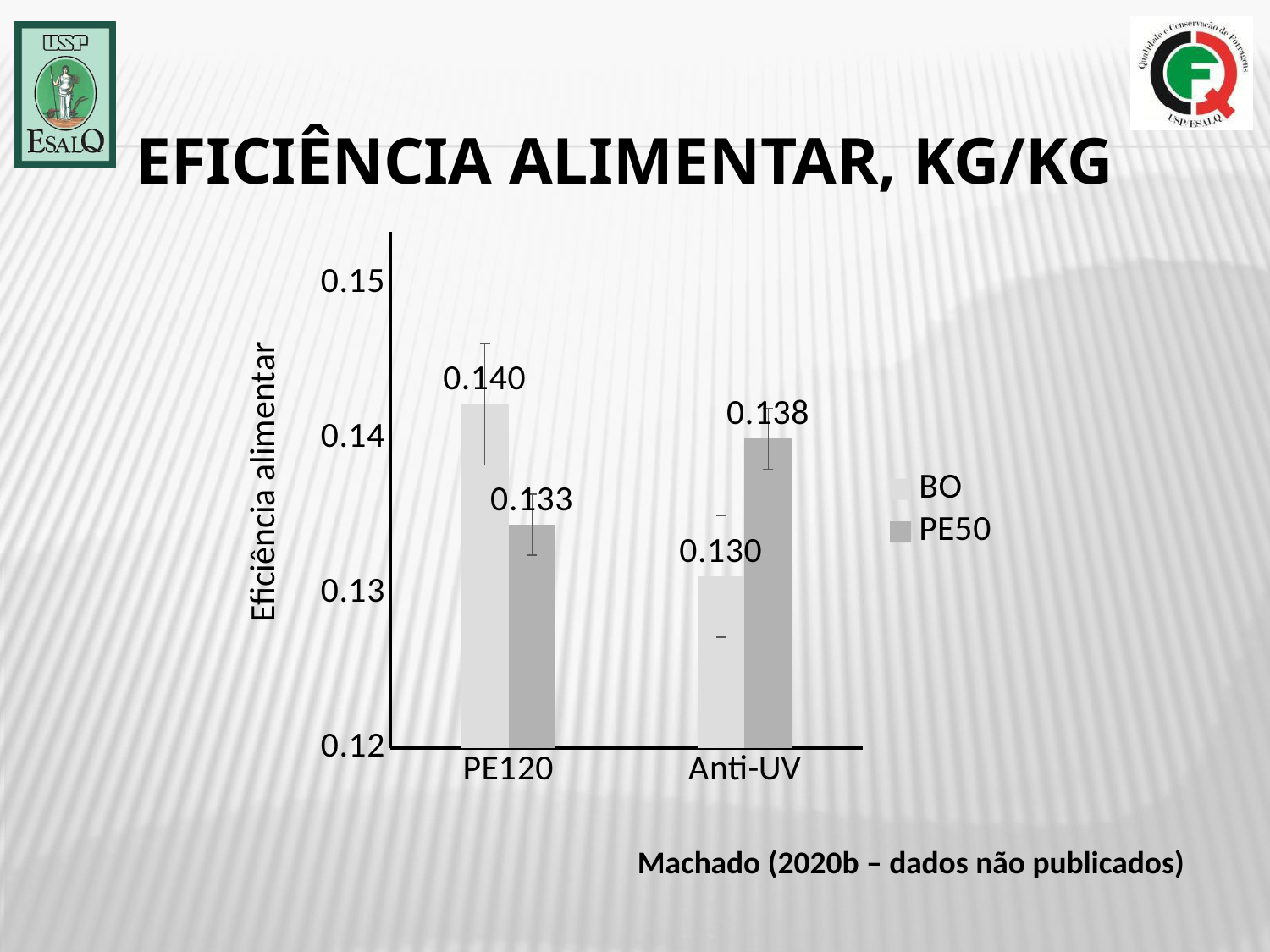
In the Anti-UV category, which series has the larger value, BO or PE50? PE50 What is the value for PE50 in the Anti-UV category? 0.138 How many series does the legend list? 2 What is the value for BO in the PE120 category? 0.140 Which bar has the highest value on the chart? BO in PE120 What is the difference between the PE50 and BO values in the Anti-UV category? 0.008 What is the difference between the BO and PE50 values in the PE120 category? 0.007 What is the value for PE50 in the PE120 category? 0.133 How many categories are shown on the x axis? 2 What is the value for BO in the Anti-UV category? 0.130 Which bar has the lowest value on the chart? BO in Anti-UV What kind of chart is shown on the slide? Bar chart